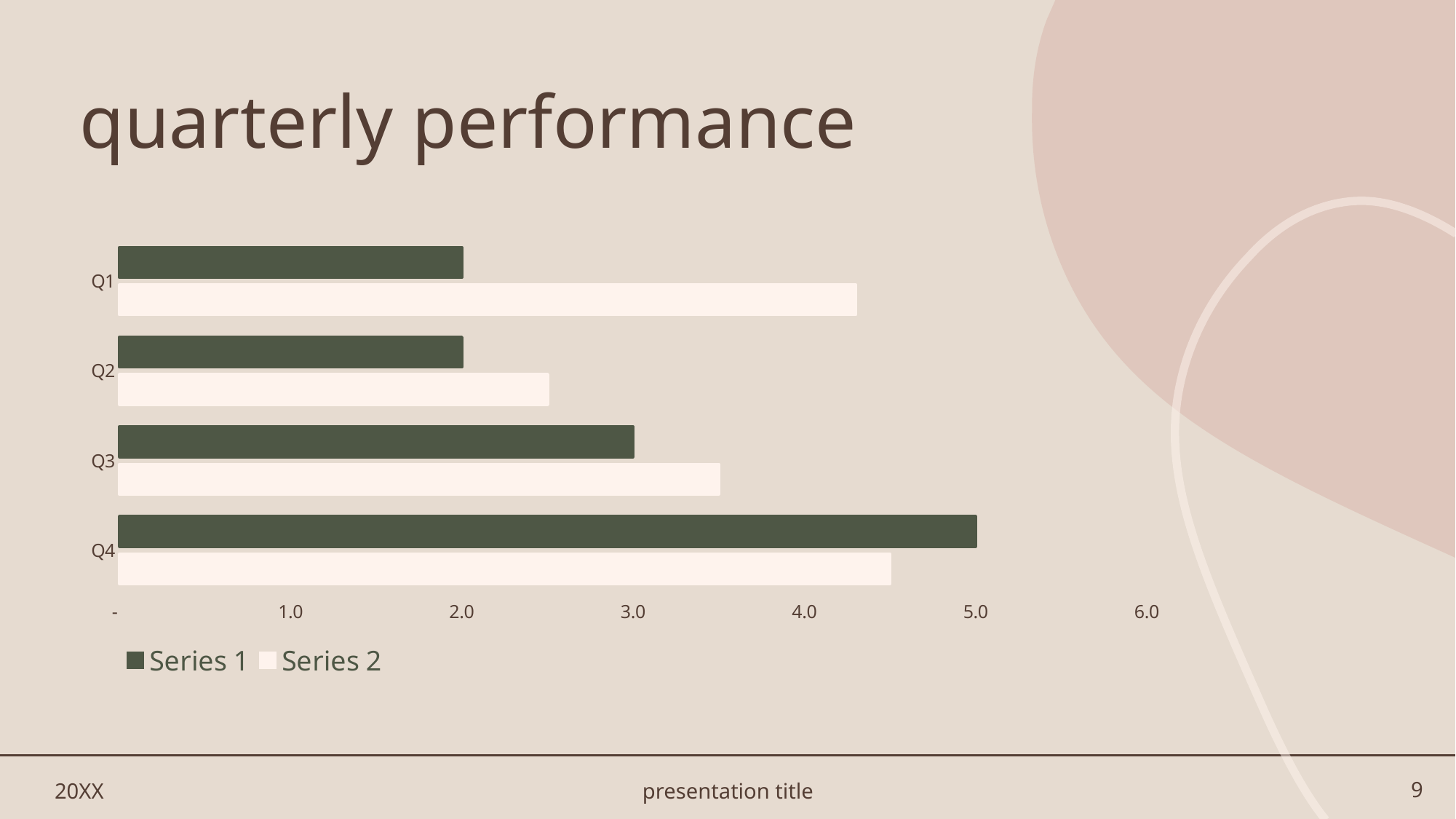
How many series does the legend list? 2 What is the value of Series 1 for Q4? 5.0 For Q4, which series has the larger value, Series 1 or Series 2? Series 1 Is the value of Series 2 for Q1 greater or less than 4.0? greater How many quarters are shown on the chart? 4 What is the value of Series 1 for Q3? 3.0 What is the title of the slide? quarterly performance Which quarter has the lowest value for Series 2? Q2 Is the value of Series 2 for Q2 greater or less than 3.0? less What kind of chart is shown on the slide? bar chart Which quarter has the highest value for Series 1? Q4 What is the difference between the Series 1 values for Q4 and Q1? 3.0